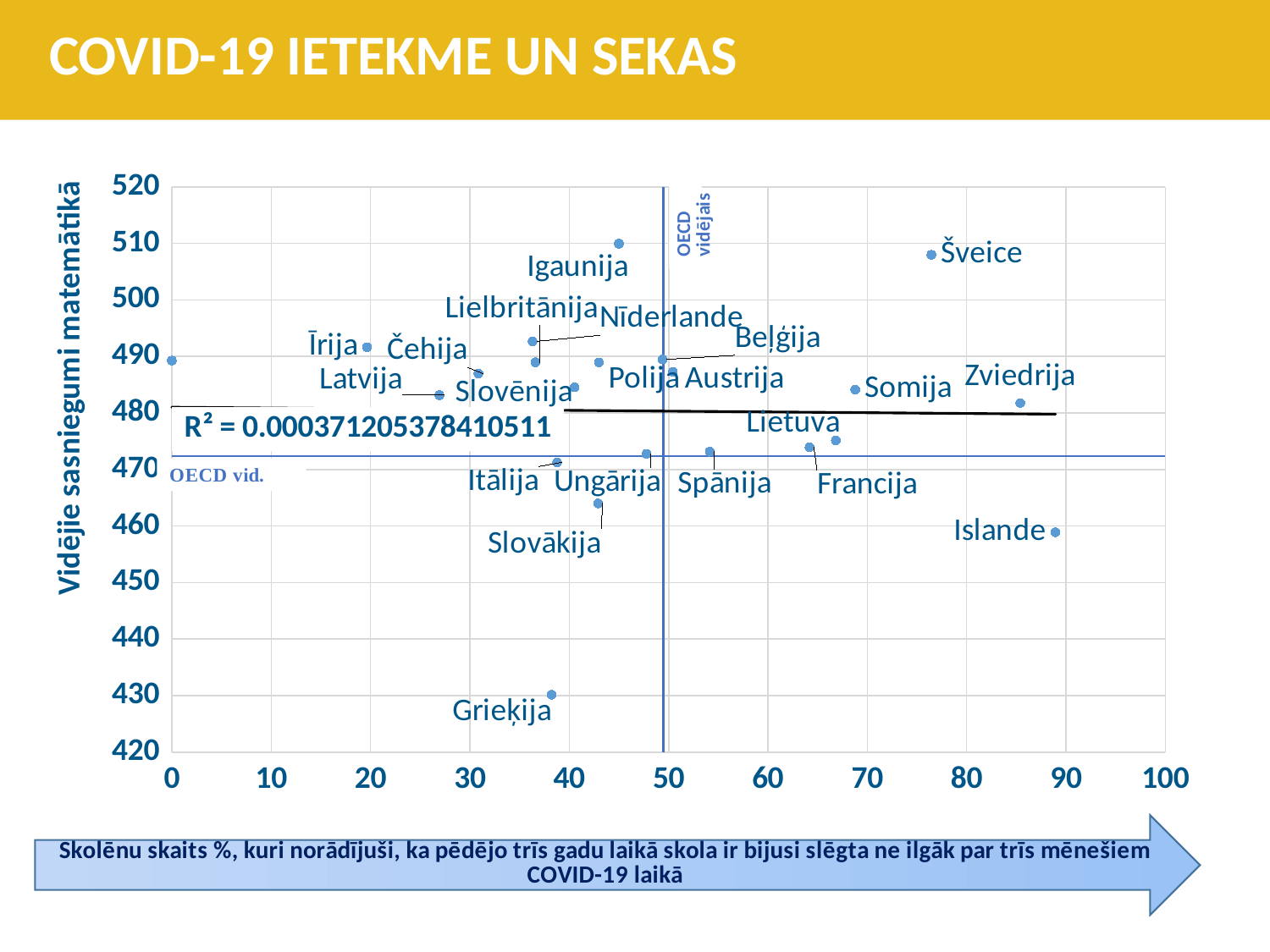
Which has the higher average mathematics score, Slovākija or Grieķija? Slovākija What kind of chart is shown on the slide? scatter chart Which has the higher average mathematics score, Šveice or Islande? Šveice Is the average mathematics score for Grieķija greater or less than 440? less Which country has the lowest average mathematics score on the chart? Grieķija What R² value is printed on the chart? R² = 0.000371205378410511 What is the label of the vertical axis? Vidējie sasniegumi matemātikā Is the horizontal-axis value for Latvija greater or less than 30? less Is the horizontal-axis value for Somija greater or less than 60? greater Which country is plotted furthest to the right on the horizontal axis? Islande